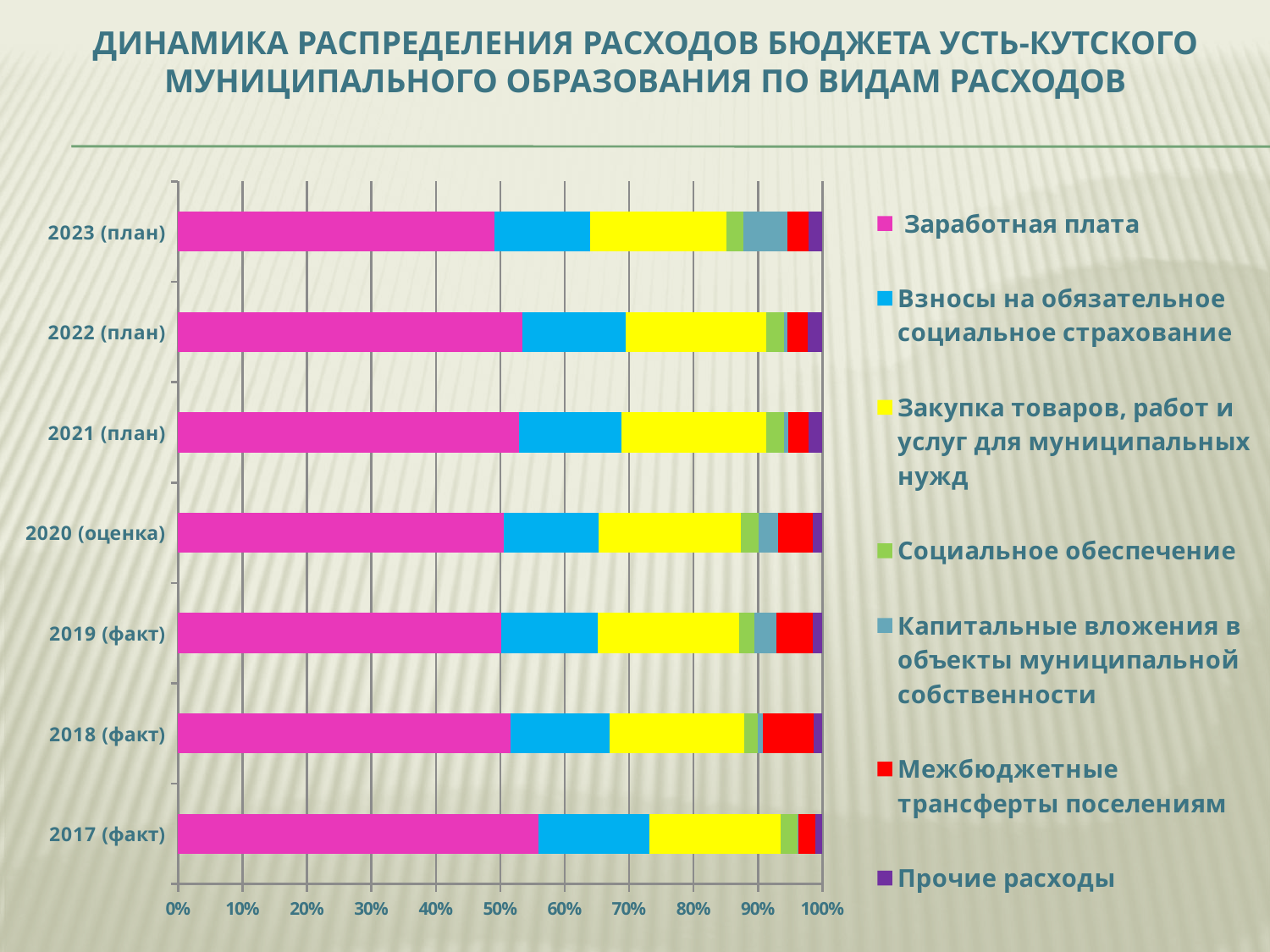
How many series does the legend list? 7 Is the share of Заработная плата for 2022 (план) greater or less than 50%? greater What kind of chart is shown on the slide? stacked bar chart Is the share of Заработная плата for 2018 (факт) greater or less than 60%? less Which series is shown in magenta (pink) on the chart? Заработная плата What is the maximum value shown on the horizontal axis? 100% Which year has the largest share of Заработная плата? 2017 (факт) Is the share of Заработная плата for 2017 (факт) greater or less than 50%? greater Which year has the largest share of Межбюджетные трансферты поселениям? 2018 (факт) How many budget years (categories) are shown on the chart? 7 Which is larger: the share of Заработная плата in 2017 (факт) or in 2023 (план)? 2017 (факт)